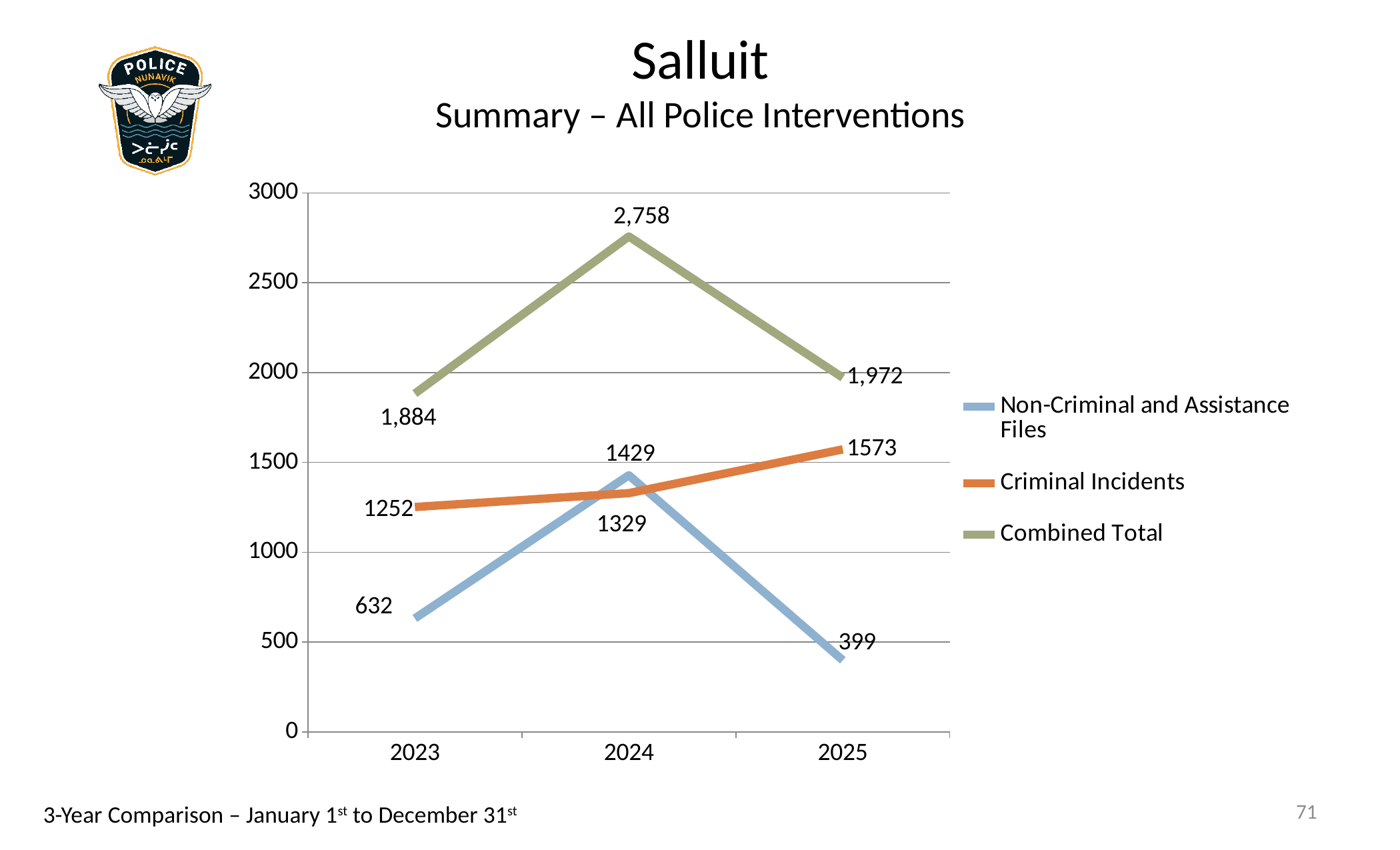
What is the difference between Criminal Incidents in 2025 and in 2023? 321 What is the value for Criminal Incidents in 2025? 1573 What is the value for Non-Criminal and Assistance Files in 2024? 1429 What kind of chart is shown on the slide? line chart What is the Combined Total for 2023? 1,884 How many years are shown on the x axis? 3 Is the Combined Total for 2025 greater or less than 2000? less In which year is the Combined Total highest? 2024 In which year is the value for Non-Criminal and Assistance Files lowest? 2025 How many series does the legend list? 3 Which is larger in 2024: Non-Criminal and Assistance Files or Criminal Incidents? Non-Criminal and Assistance Files Do the values for Criminal Incidents rise or fall from 2023 to 2025? rise